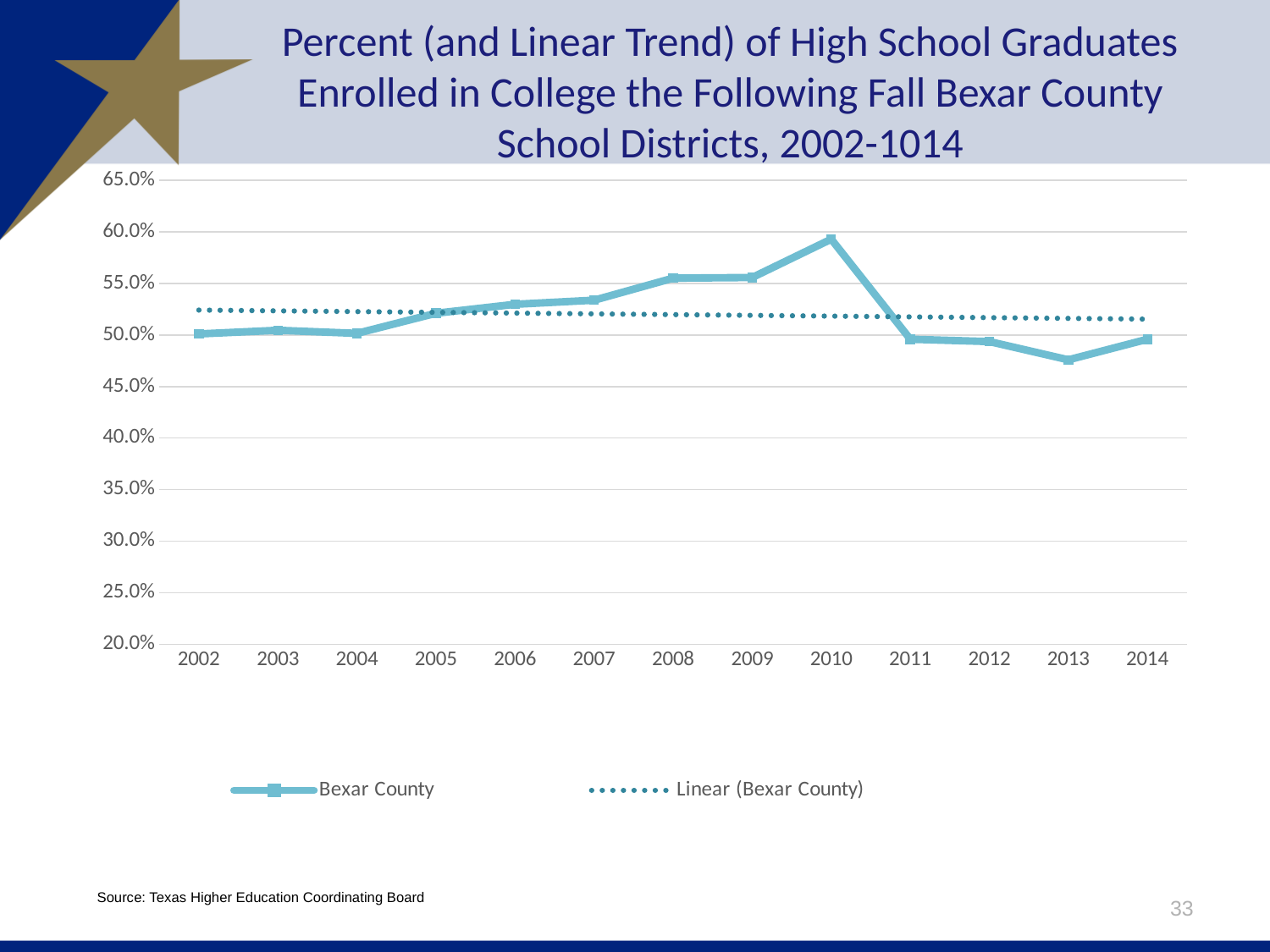
In which year was the percent of high school graduates enrolled in college the lowest? 2013 Which year has the larger value, 2005 or 2013? 2005 What kind of chart is shown on the slide? Line chart Is the value for 2008 greater or less than 50.0%? greater In which year was the percent of high school graduates enrolled in college the highest? 2010 Is the value for 2013 greater or less than 50.0%? less How many years are plotted on the x axis? 13 Do the Bexar County values rise or fall from 2004 to 2010? Rise Is the value for 2010 greater or less than 55.0%? greater How many entries does the legend list? 2 What source is cited at the bottom of the slide? Texas Higher Education Coordinating Board Which year has the larger value, 2010 or 2002? 2010